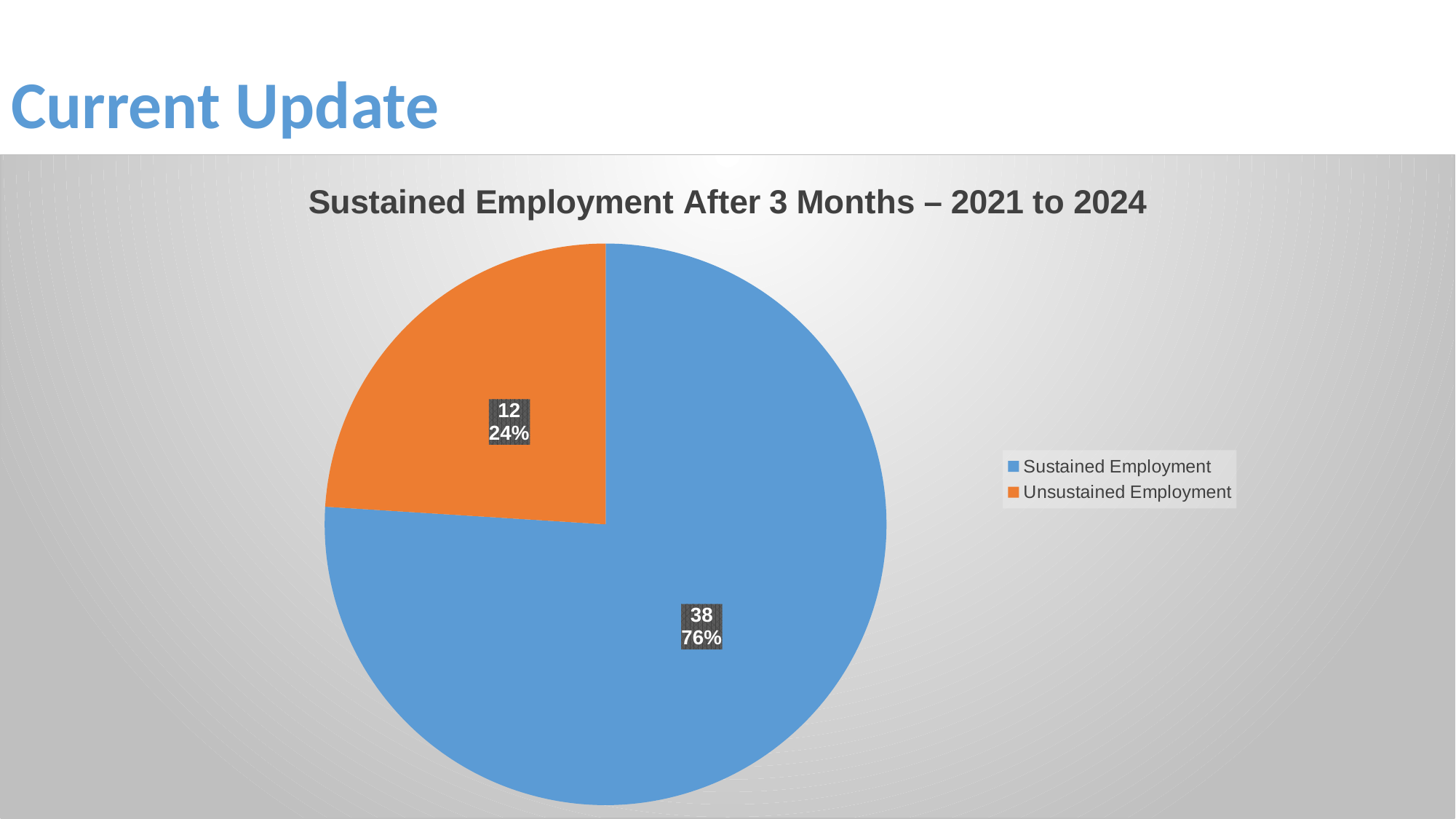
Which category has the largest slice? Sustained Employment How many categories does the pie chart have? 2 What is the title of the chart? Sustained Employment After 3 Months – 2021 to 2024 What share of the pie does Unsustained Employment represent? 24% What is the value for Unsustained Employment? 12 Which is larger, Sustained Employment or Unsustained Employment? Sustained Employment Which category has the smallest slice? Unsustained Employment What is the value for Sustained Employment? 38 What is the difference between the Sustained Employment and Unsustained Employment values? 26 What kind of chart is shown on the slide? pie chart What is the total of the two slices? 50 What share of the pie does Sustained Employment represent? 76%